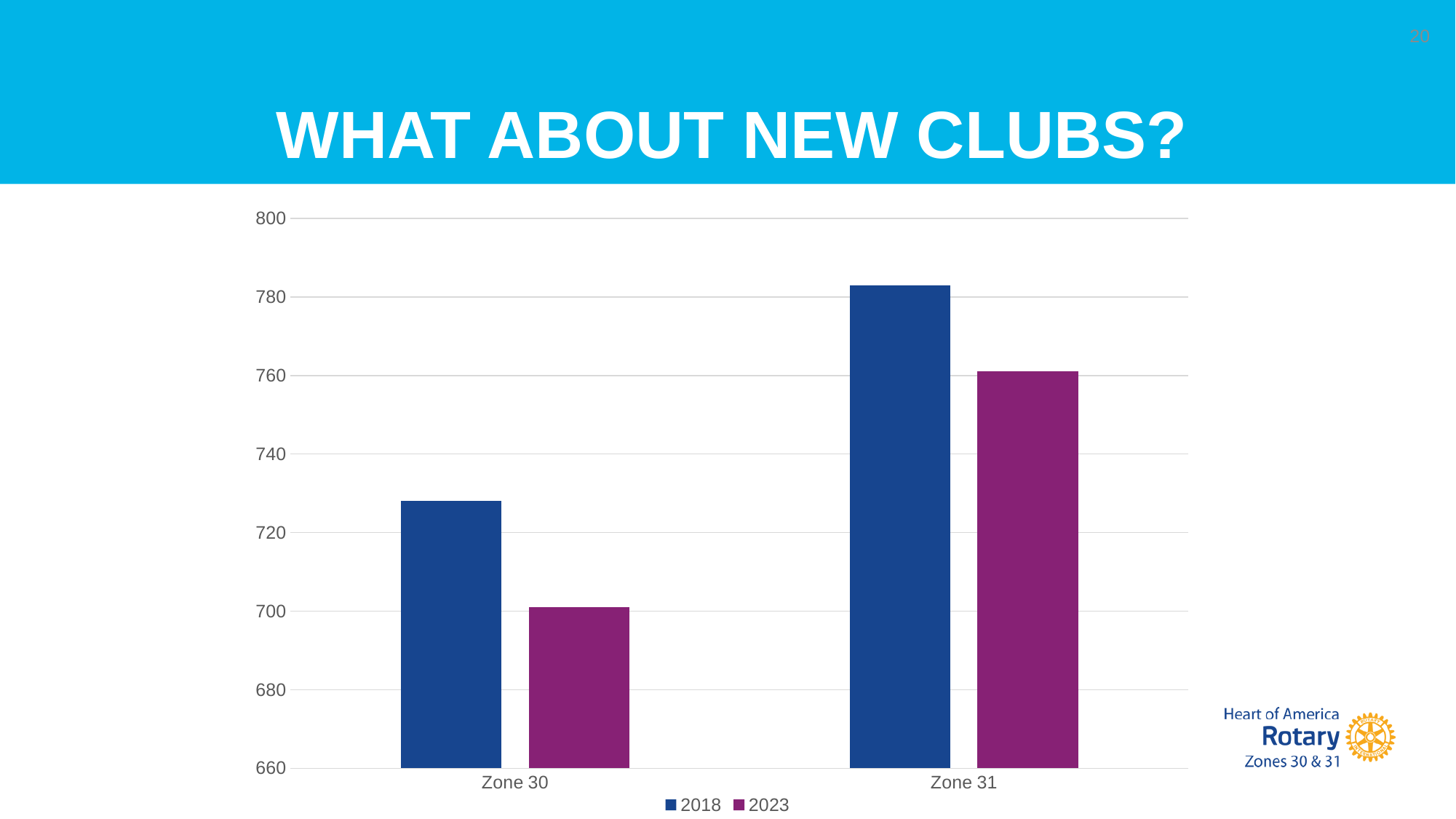
Is the 2018 value for Zone 30 greater or less than 720? greater How many series does the legend list? 2 Which series is shown in purple? 2023 Is the 2023 value for Zone 31 greater or less than 780? less What is the title of the slide containing the chart? WHAT ABOUT NEW CLUBS? What kind of chart is shown on the slide? bar chart Is the 2023 value for Zone 30 greater or less than 720? less Which bar is the shortest in the chart? Zone 30, 2023 How many categories are shown on the x axis? 2 For Zone 30, which is larger, the 2018 value or the 2023 value? 2018 Which bar is the tallest in the chart? Zone 31, 2018